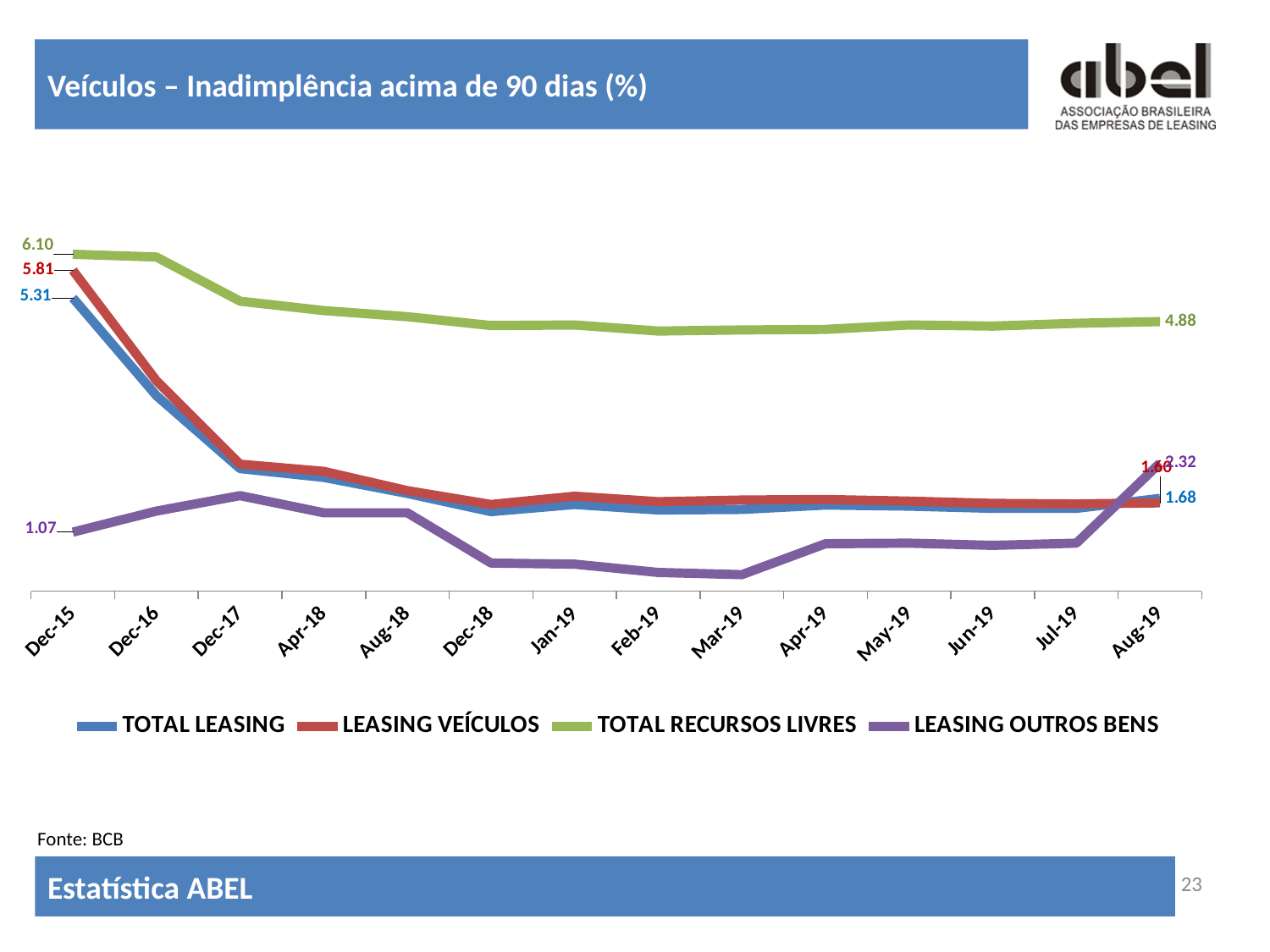
What is the value of TOTAL RECURSOS LIVRES at Dec-15? 6.10 What is the value of TOTAL LEASING at Aug-19? 1.68 What is the value of TOTAL RECURSOS LIVRES at Aug-19? 4.88 What is the value of LEASING OUTROS BENS at Dec-15? 1.07 What kind of chart is shown on the slide? line chart What is the value of LEASING VEÍCULOS at Dec-15? 5.81 By how much did TOTAL RECURSOS LIVRES fall from Dec-15 to Aug-19? 1.22 Does the TOTAL LEASING line rise or fall from Dec-15 to Aug-19? fall How many series does the legend list? 4 How many dates are shown along the x axis? 14 What is the value of TOTAL LEASING at Dec-15? 5.31 Which series has the highest value at Dec-15? TOTAL RECURSOS LIVRES